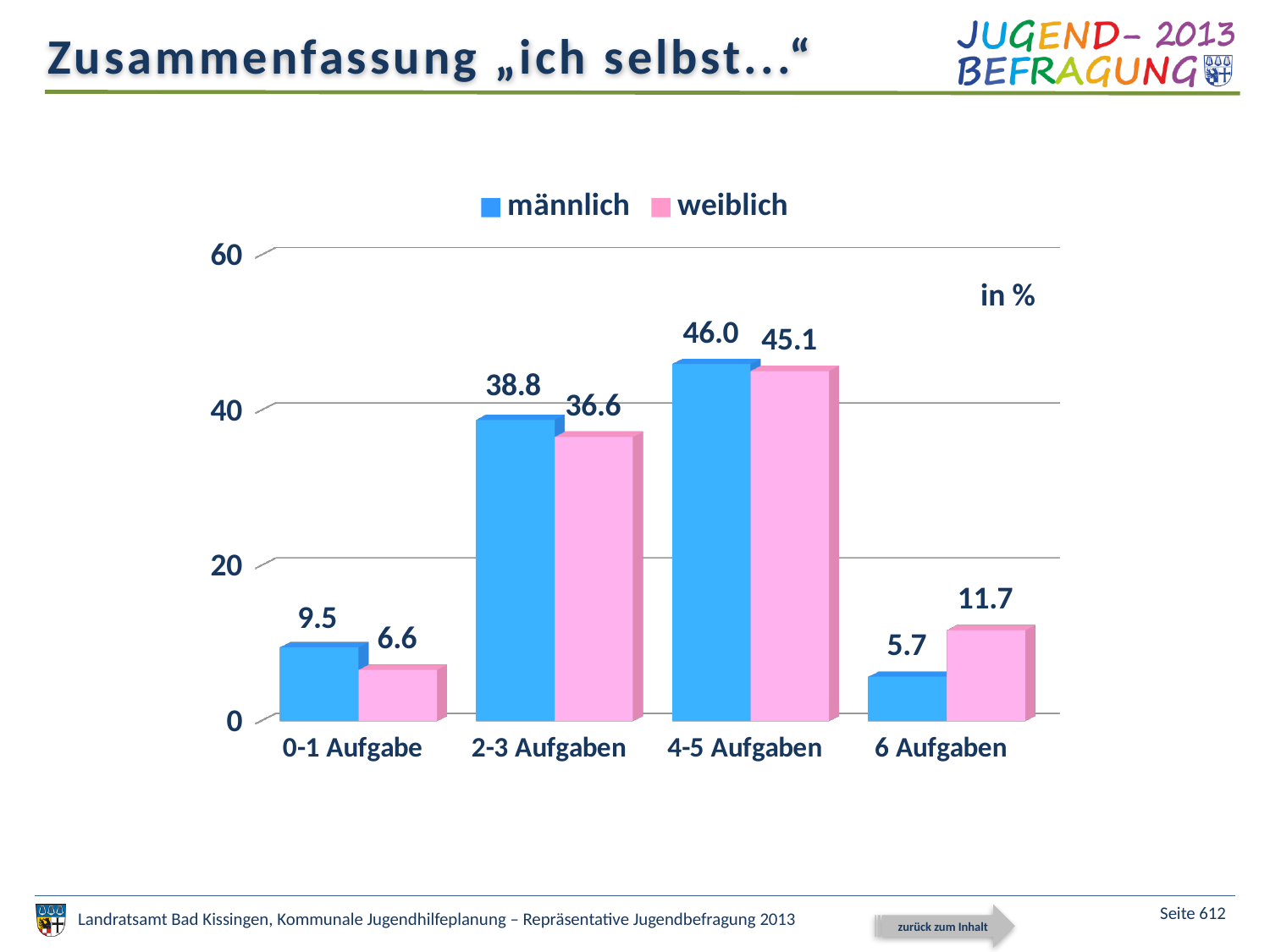
What is the value for weiblich in the 0-1 Aufgabe category? 6.6 Is the value for weiblich in the 4-5 Aufgaben category greater or less than 40? greater How many series does the legend list? 2 What is the difference between männlich and weiblich in the 6 Aufgaben category? 6.0 Which category has the highest value for männlich? 4-5 Aufgaben What kind of chart is shown on the slide? bar chart What is the value for weiblich in the 6 Aufgaben category? 11.7 How many categories are shown on the x axis? 4 Which is larger in the 2-3 Aufgaben category, männlich or weiblich? männlich What is the value for männlich in the 2-3 Aufgaben category? 38.8 Which category has the lowest value for weiblich? 0-1 Aufgabe Which colour represents the weiblich series? pink